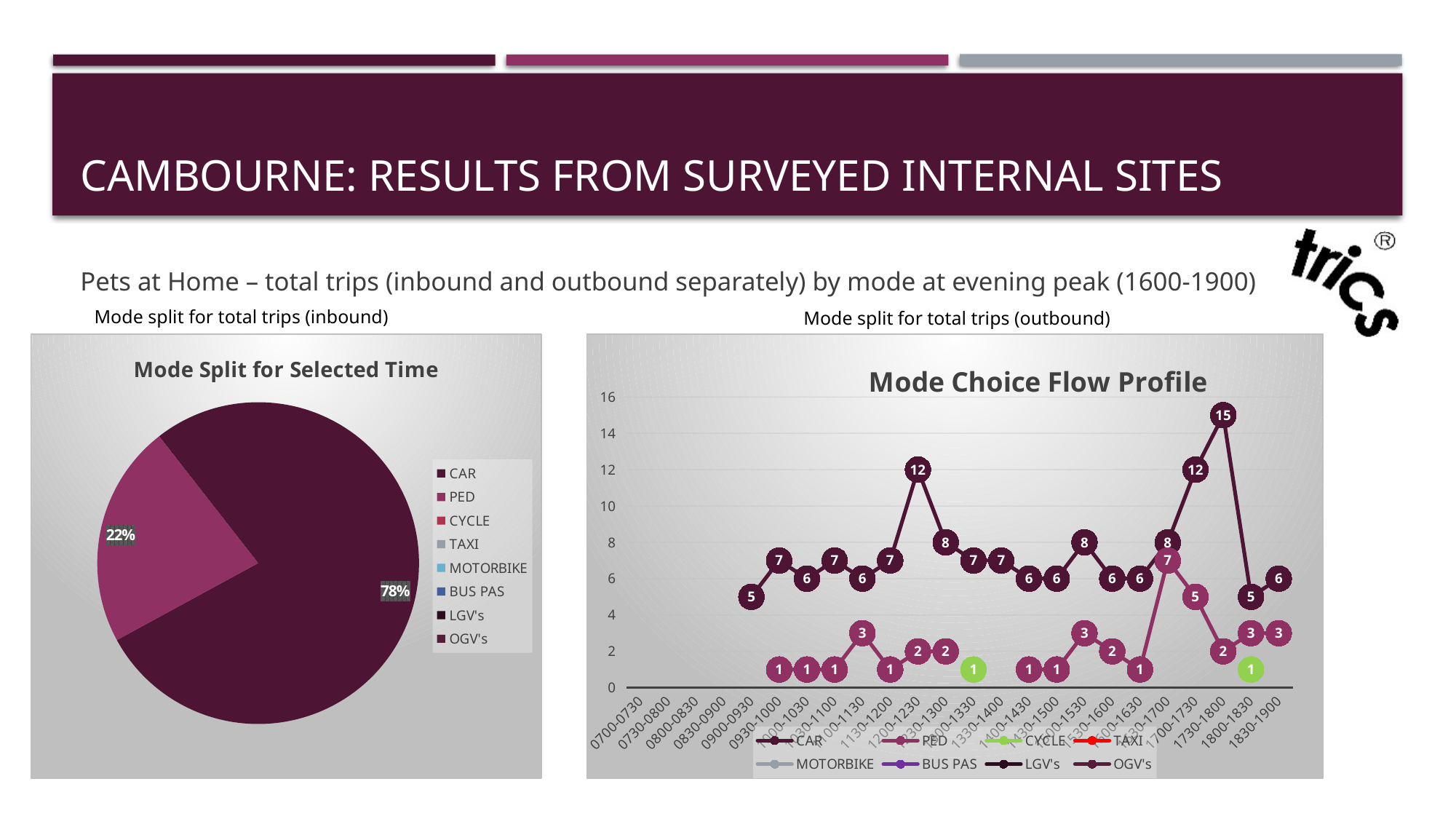
What kind of chart is the 'Mode Choice Flow Profile' chart on the right? Line chart In the 'Mode Choice Flow Profile' chart, what is the CAR value for 1830-1900? 6 How many entries does the legend of the 'Mode Split for Selected Time' pie chart list? 8 What kind of chart is the 'Mode Split for Selected Time' chart on the left? Pie chart In the pie chart 'Mode Split for Selected Time' (inbound), what share of trips is CAR? 78% In the 'Mode Choice Flow Profile' chart, what is the difference between the CAR values at 1730-1800 (15) and 1700-1730 (12)? 3 In the 'Mode Choice Flow Profile' chart, how many series does the legend list? 8 In the 'Mode Choice Flow Profile' chart, what is the highest value reached by the CAR series? 15 In the pie chart 'Mode Split for Selected Time', which slice is larger, CAR or PED? CAR In the 'Mode Choice Flow Profile' chart, what is the highest value reached by the PED series? 7 In the 'Mode Choice Flow Profile' chart, what is the CAR value for 1200-1230? 12 In the pie chart 'Mode Split for Selected Time' (inbound), what share of trips is PED? 22%